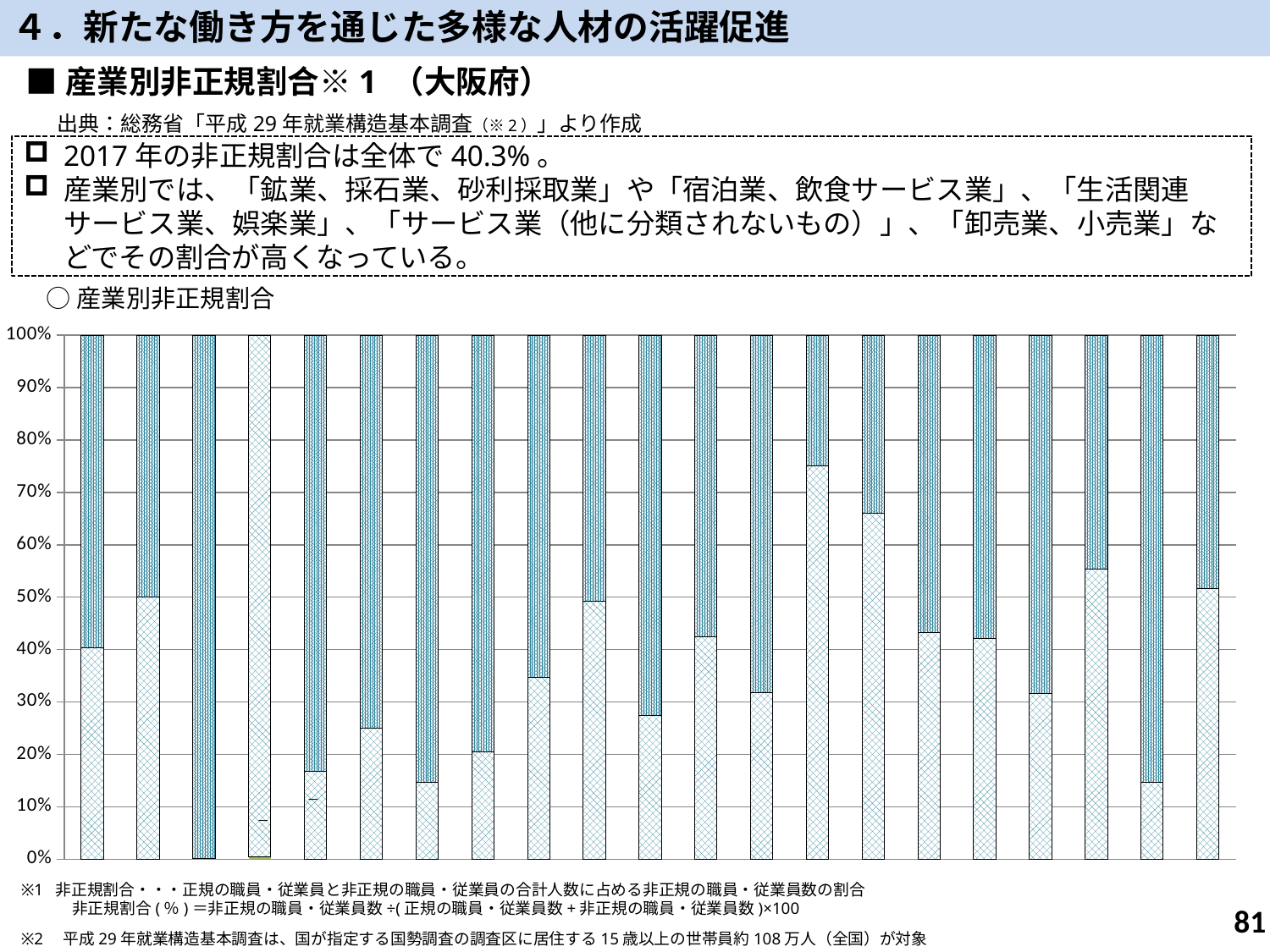
Is the lower (cross-hatched) segment of the leftmost bar greater or less than 50%? less Which bar has the largest lower (cross-hatched) segment: the fourth bar from the left or the fourteenth bar from the left? the fourth bar from the left Is the lower (cross-hatched) segment of the fifth bar from the left greater or less than 20%? less Is the lower (cross-hatched) segment of the fourth bar from the left greater or less than 90%? greater Which bar has the larger lower (cross-hatched) segment: the second bar from the left or the third bar from the left? the second bar from the left What is the highest value shown on the vertical axis of the chart? 100% How many bars are plotted in the chart? 21 What is the title printed above the chart? 産業別非正規割合 What kind of chart is shown on the slide? bar chart